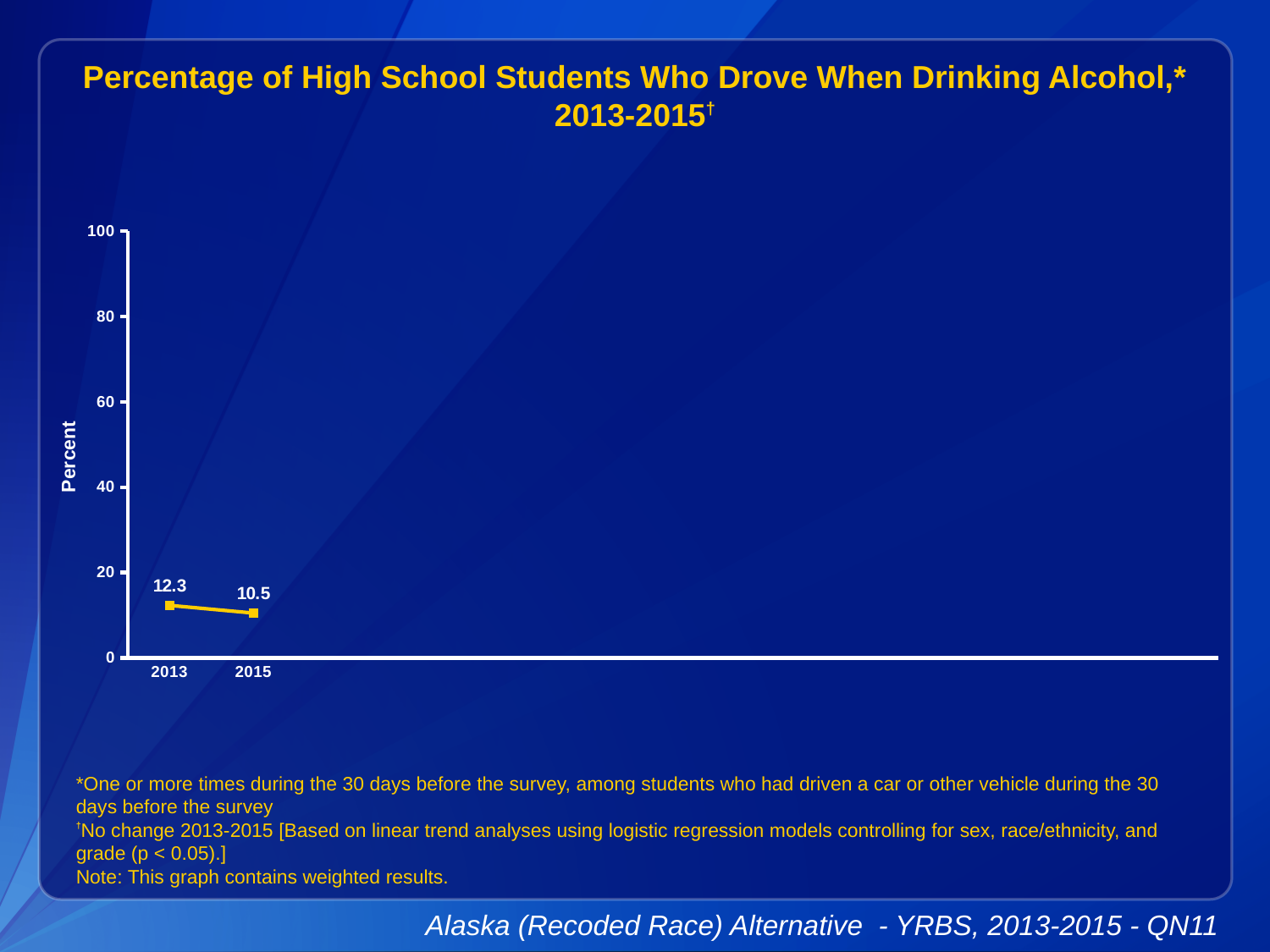
Is the value for 2013 greater or less than 20? less How many years are plotted on the chart? 2 What is the percentage of high school students who drove when drinking alcohol in 2013? 12.3 Do the values rise or fall from 2013 to 2015? fall What is the percentage of high school students who drove when drinking alcohol in 2015? 10.5 By how many percentage points did the value change from 2013 to 2015? 1.8 What is the label on the y axis of the chart? Percent Is the value for 2015 greater or less than 20? less What kind of chart is shown on the slide? line chart Which year shows the lowest percentage on the chart? 2015 What is the maximum value shown on the y axis? 100 Which year has the higher percentage, 2013 or 2015? 2013